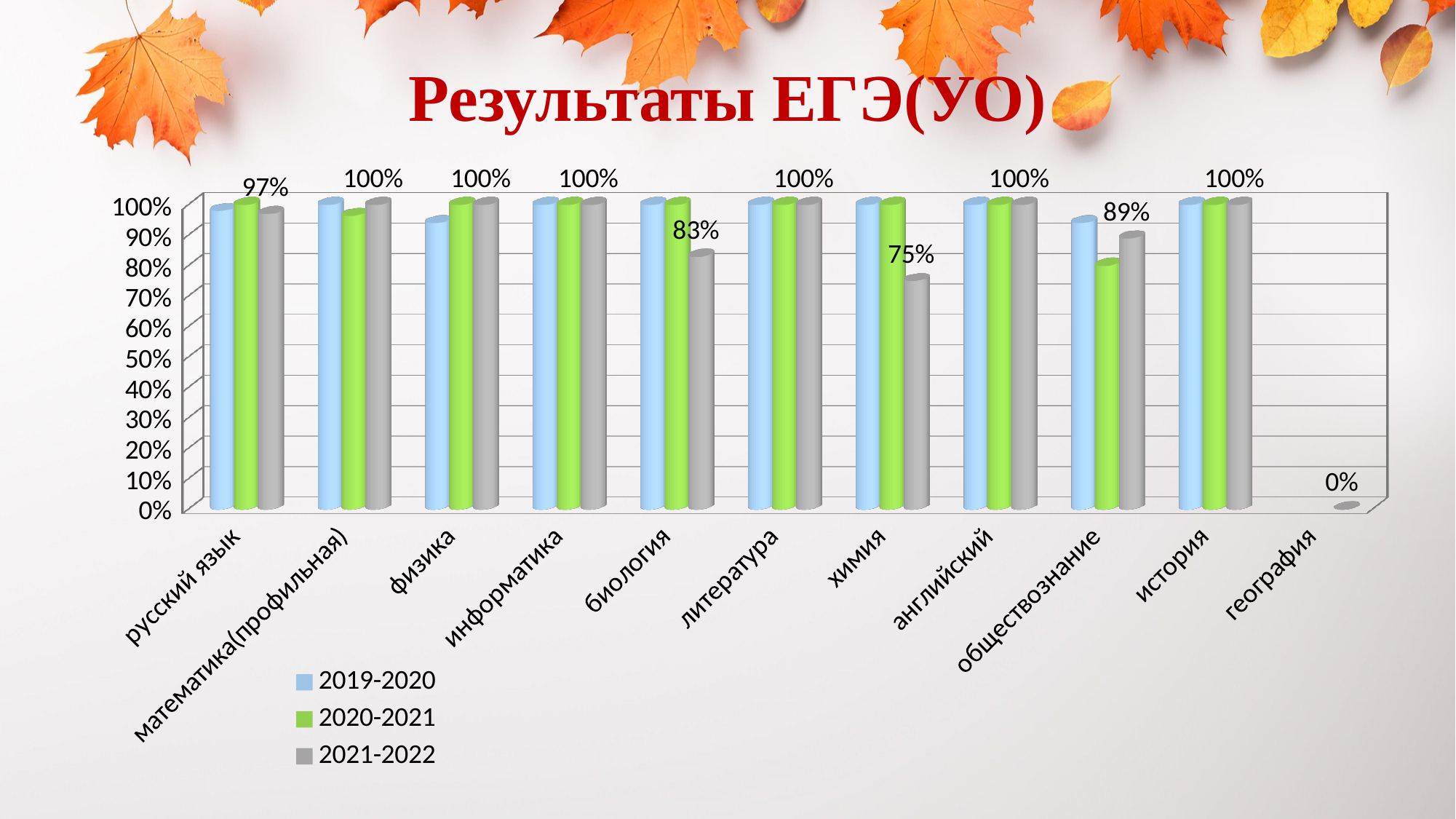
Which category has the lowest value in the 2021-2022 series? география What is the difference between the 2021-2022 values for биология and химия? 8% What is the value for русский язык in the 2021-2022 series? 97% How many categories are shown on the x axis? 11 How many series does the legend list? 3 What kind of chart is shown on the slide? bar chart What is the value for химия in the 2021-2022 series? 75% What is the value for биология in the 2021-2022 series? 83% What is the value for обществознание in the 2021-2022 series? 89% Is the value for физика in the 2019-2020 series greater or less than 80%? greater Is the value for обществознание in the 2020-2021 series greater or less than 90%? less In the 2021-2022 series, which is larger: обществознание or биология? обществознание